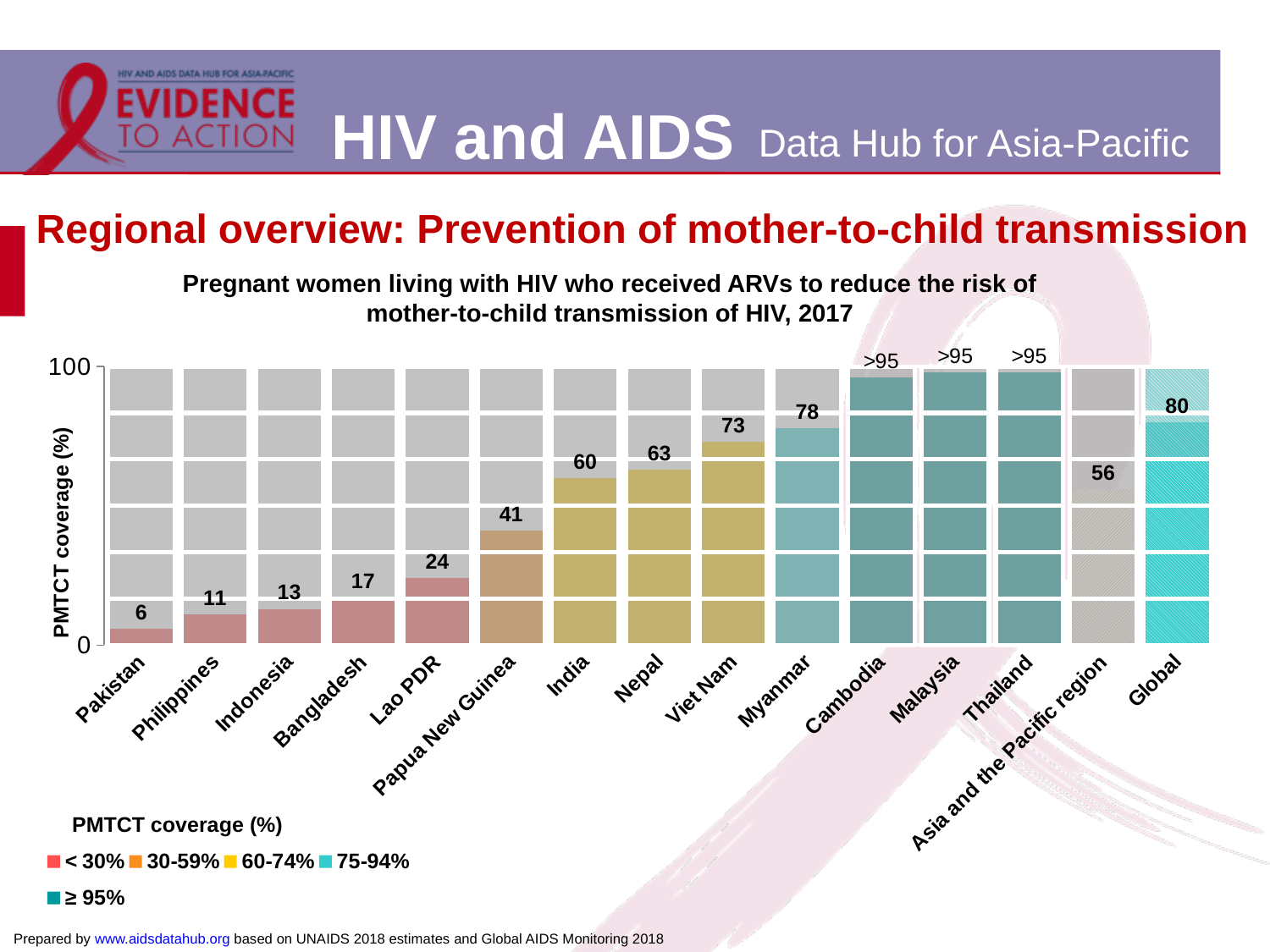
What is the difference between the Global value and the Asia and the Pacific region value? 24 What is the PMTCT coverage value shown for the Asia and the Pacific region? 56 How many categories are shown on the x axis of the chart? 15 What is the PMTCT coverage value shown for Viet Nam? 73 Which has a higher PMTCT coverage, Viet Nam or Myanmar? Myanmar What kind of chart is shown on the slide? Bar chart What value is shown for Cambodia? >95 What is the PMTCT coverage value shown for Pakistan? 6 Is the value for Nepal greater or less than 50? greater How many coverage ranges does the legend list? 5 What is the PMTCT coverage value shown for Papua New Guinea? 41 Which country has the lowest PMTCT coverage on the chart? Pakistan